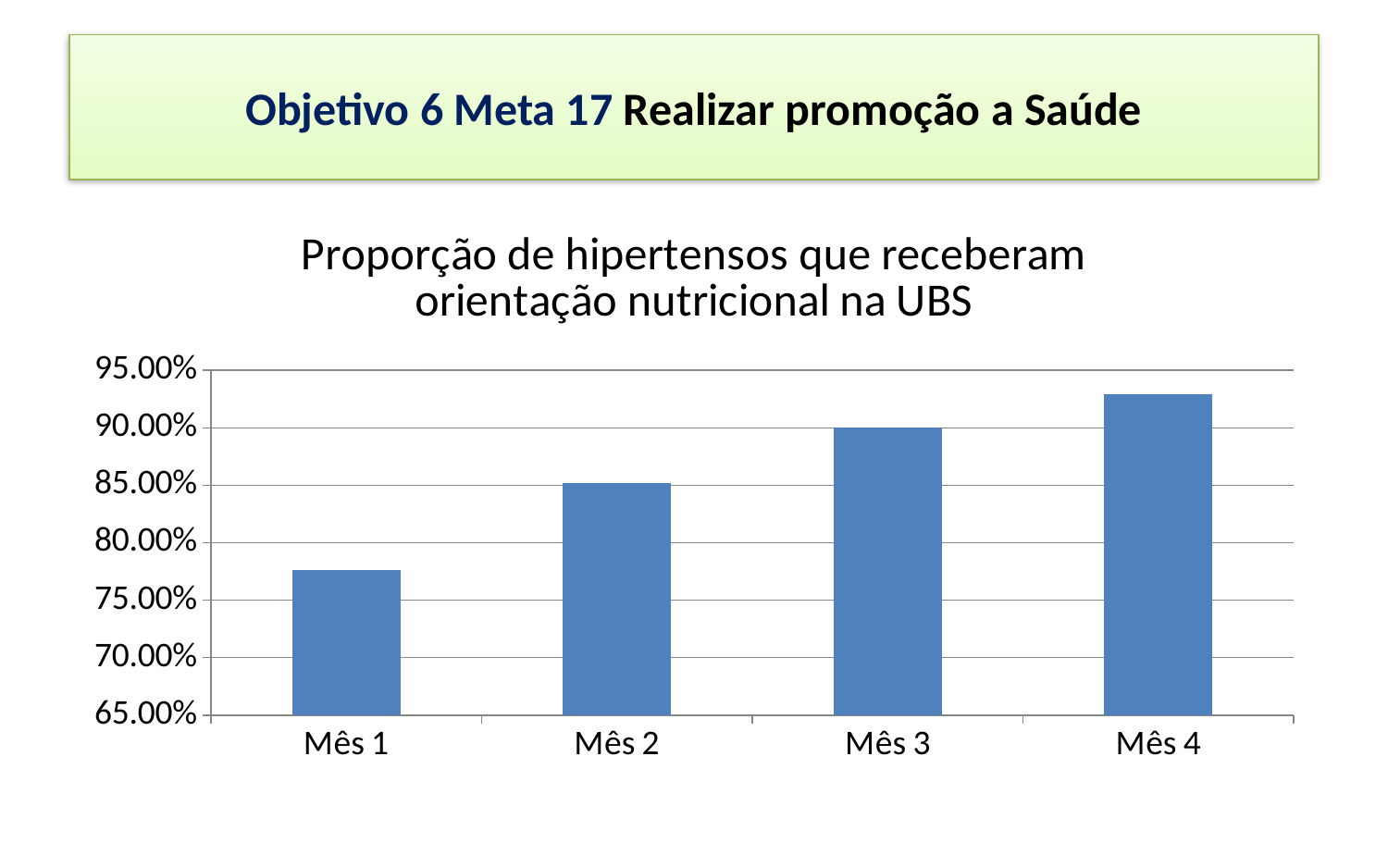
Which is larger, the value for Mês 2 or the value for Mês 3? Mês 3 Which month has the lowest proportion of hypertensive patients who received nutritional guidance? Mês 1 Is the value for Mês 1 greater or less than 75.00%? greater What is the title of the chart? Proporção de hipertensos que receberam orientação nutricional na UBS Do the values rise or fall from Mês 1 to Mês 4? rise Is the value for Mês 4 greater or less than 90.00%? greater How many categories (months) are plotted on the chart? 4 What is the lowest value shown on the vertical axis? 65.00% Which month has the highest proportion of hypertensive patients who received nutritional guidance? Mês 4 Is the value for Mês 1 greater or less than 80.00%? less What kind of chart is shown on the slide? bar chart